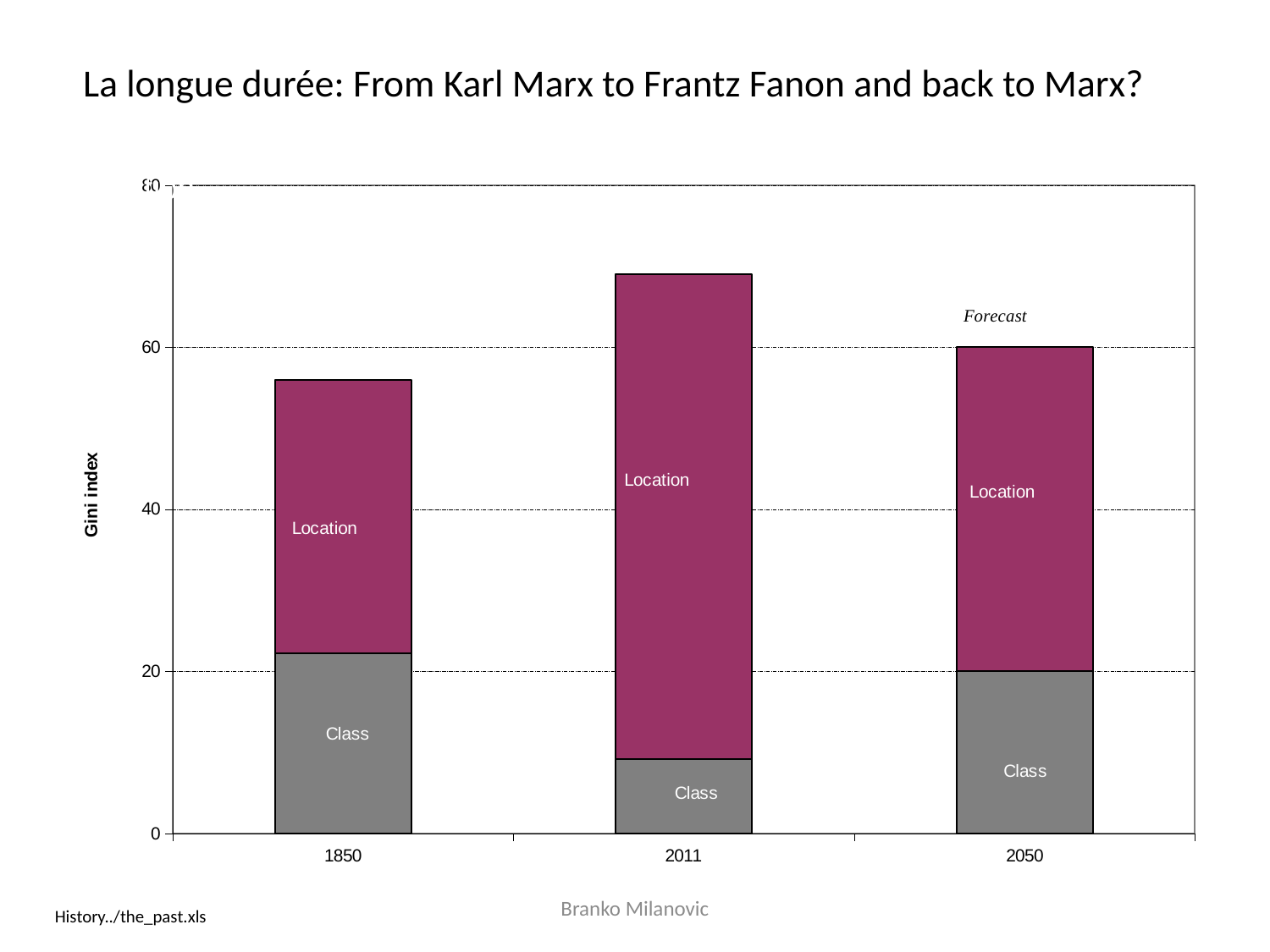
Is the total bar for 1850 greater or less than 40? greater Is the Class segment for 2011 greater or less than 20? less Which year's bar is annotated as a forecast? 2050 How many years (categories) are shown on the x axis? 3 Which year has the lowest total Gini index bar? 1850 How many series (segments) make up each stacked bar? 2 Which is larger, the Class segment for 1850 or the Class segment for 2011? 1850 Is the total bar for 2011 greater or less than 60? greater Which year has the highest total Gini index bar? 2011 Which is larger, the total bar for 2011 or the total bar for 2050? 2011 What is the label on the y axis? Gini index What kind of chart is shown on the slide? Stacked bar chart